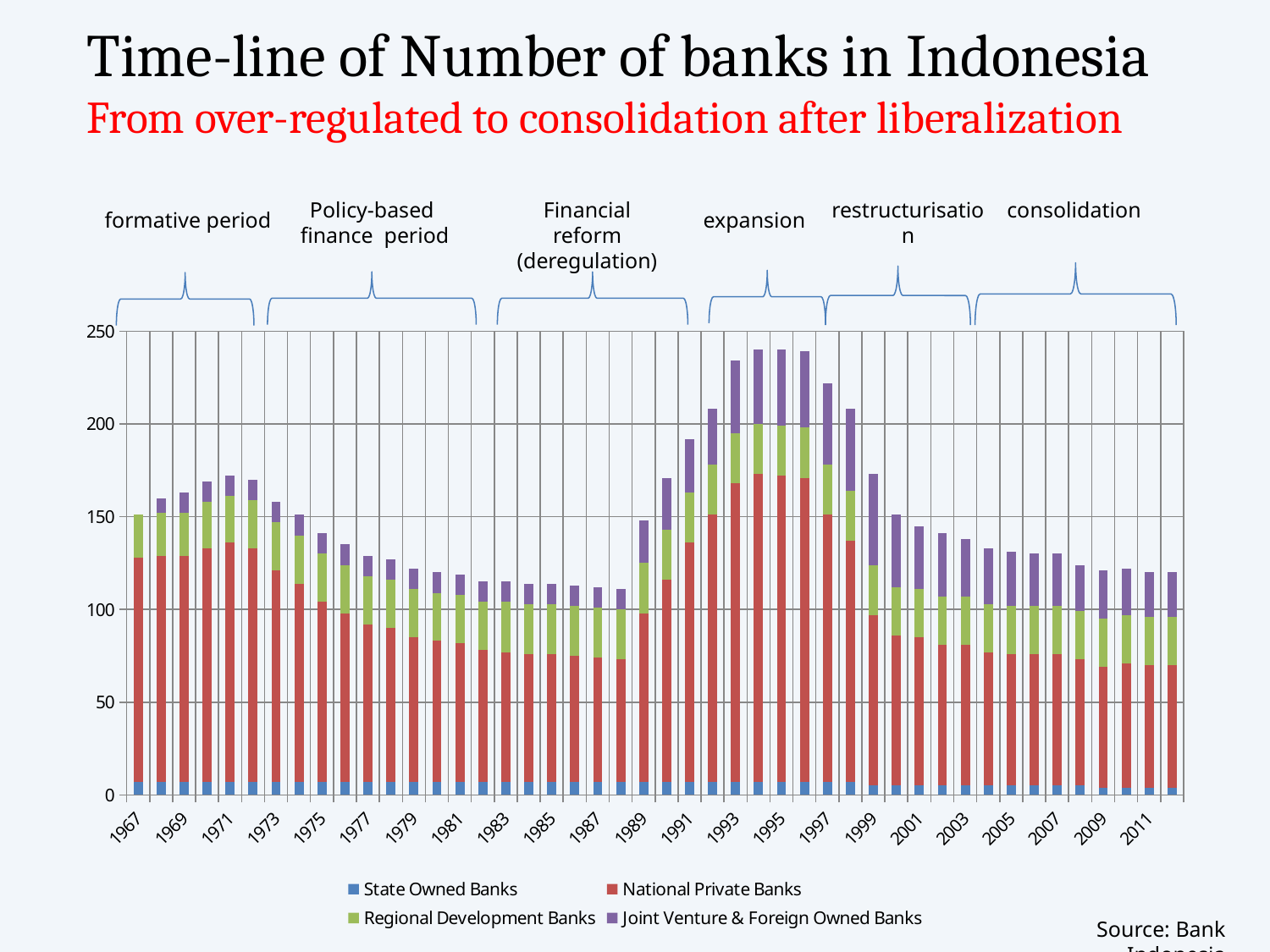
Do the total bar heights rise or fall from 1997 to 2011? fall Which year has the larger total number of banks, 1971 or 1988? 1971 Which year has the larger total number of banks, 1995 or 2005? 1995 Is the total number of banks in 2011 greater or less than 150? less Which colour represents National Private Banks in the chart? Red Is the total number of banks in 1971 greater or less than 150? greater Is the total number of banks in 1967 greater or less than 100? greater How many series does the legend list? 4 What kind of chart is shown on the slide? Stacked bar chart Which series does the legend list first? State Owned Banks